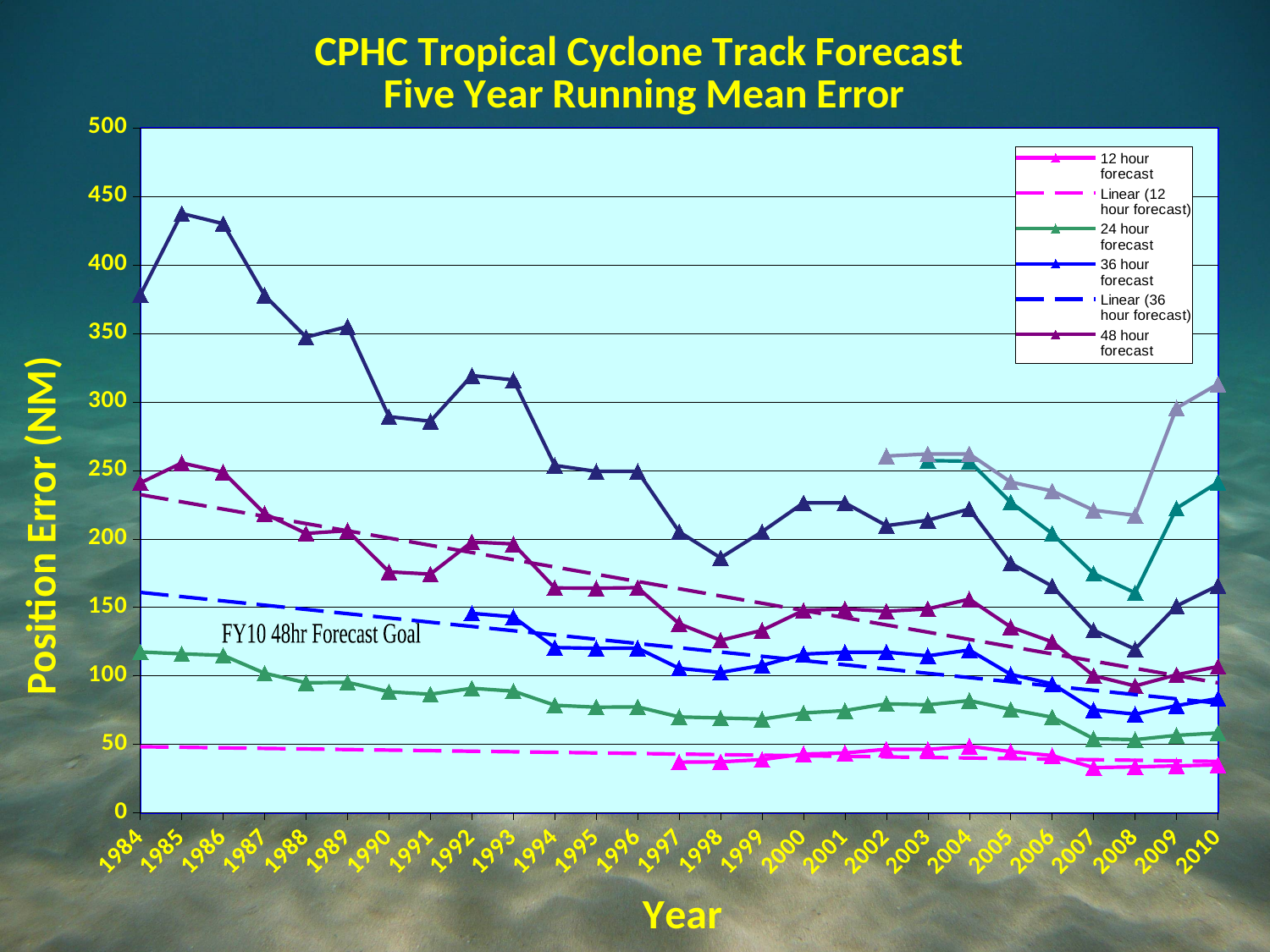
Does the 48 hour forecast error generally rise or fall from 1984 to 2010? Fall What kind of chart is shown on the slide? Line chart What is the title of the chart? CPHC Tropical Cyclone Track Forecast Five Year Running Mean Error Is the value for the 36 hour forecast in 2008 greater or less than 100? less How many series does the legend list? 6 Is the value for the 24 hour forecast in 1994 greater or less than 100? less Is the value for the 24 hour forecast in 1984 greater or less than 100? greater Which is larger for the 24 hour forecast: the value in 1984 or the value in 2010? 1984 How many years are shown along the x axis? 27 What is the label on the y axis? Position Error (NM) In which year is the 48 hour forecast error lowest? 2008